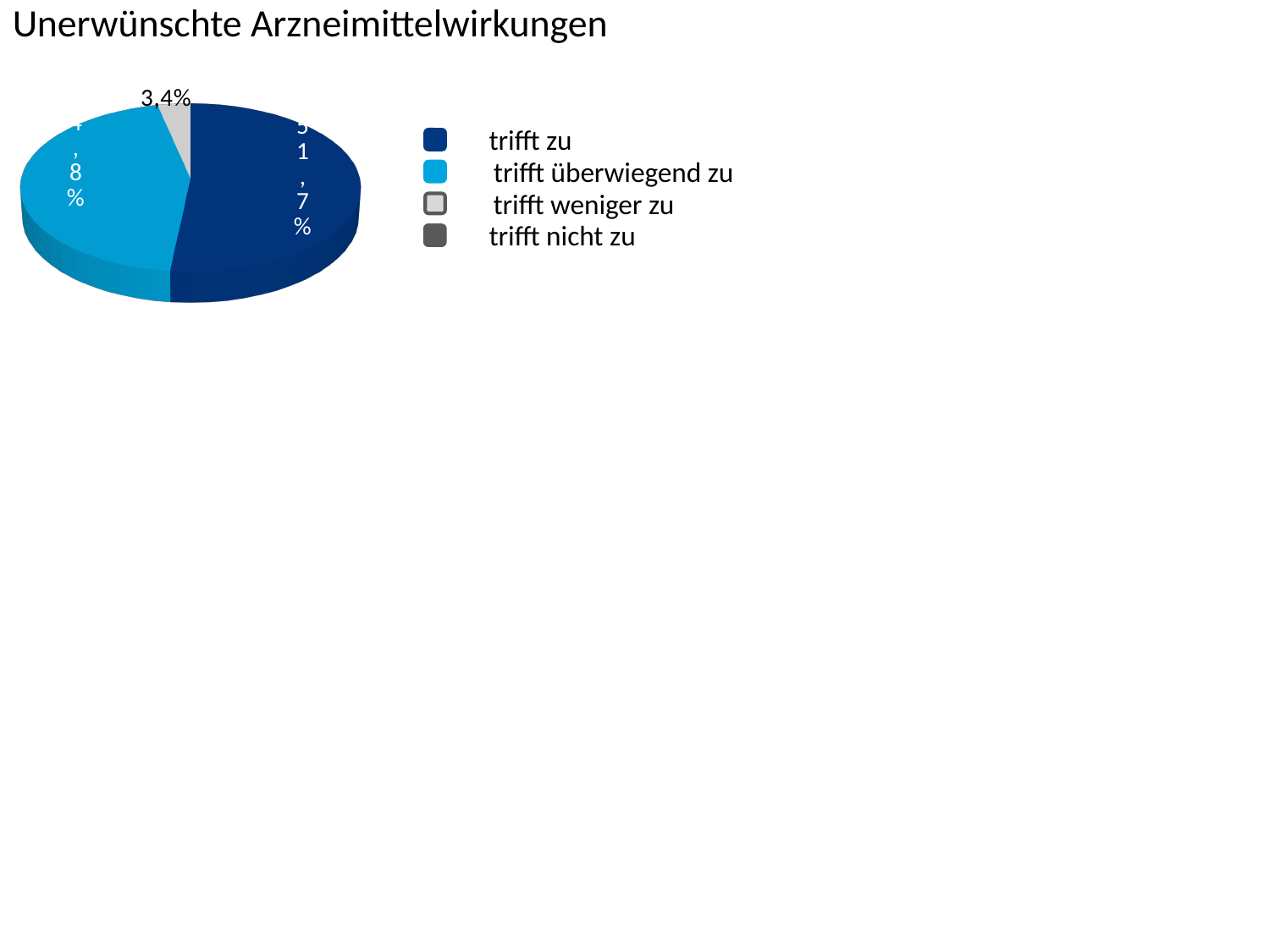
Which slice is larger, "trifft zu" or "trifft überwiegend zu"? trifft zu Which of the labelled slices is the smallest? trifft weniger zu Is the share for "trifft zu" greater or less than 50%? greater What is the share for "trifft weniger zu"? 3,4% What kind of chart is shown on the slide? pie chart What is the share for "trifft zu"? 51,7% What is the difference between the shares for "trifft zu" and "trifft weniger zu"? 48,3 percentage points How many entries does the legend list? 4 What is the title of the slide? Unerwünschte Arzneimittelwirkungen What colour represents "trifft zu" in the pie chart? dark blue Which category has the largest slice of the pie? trifft zu